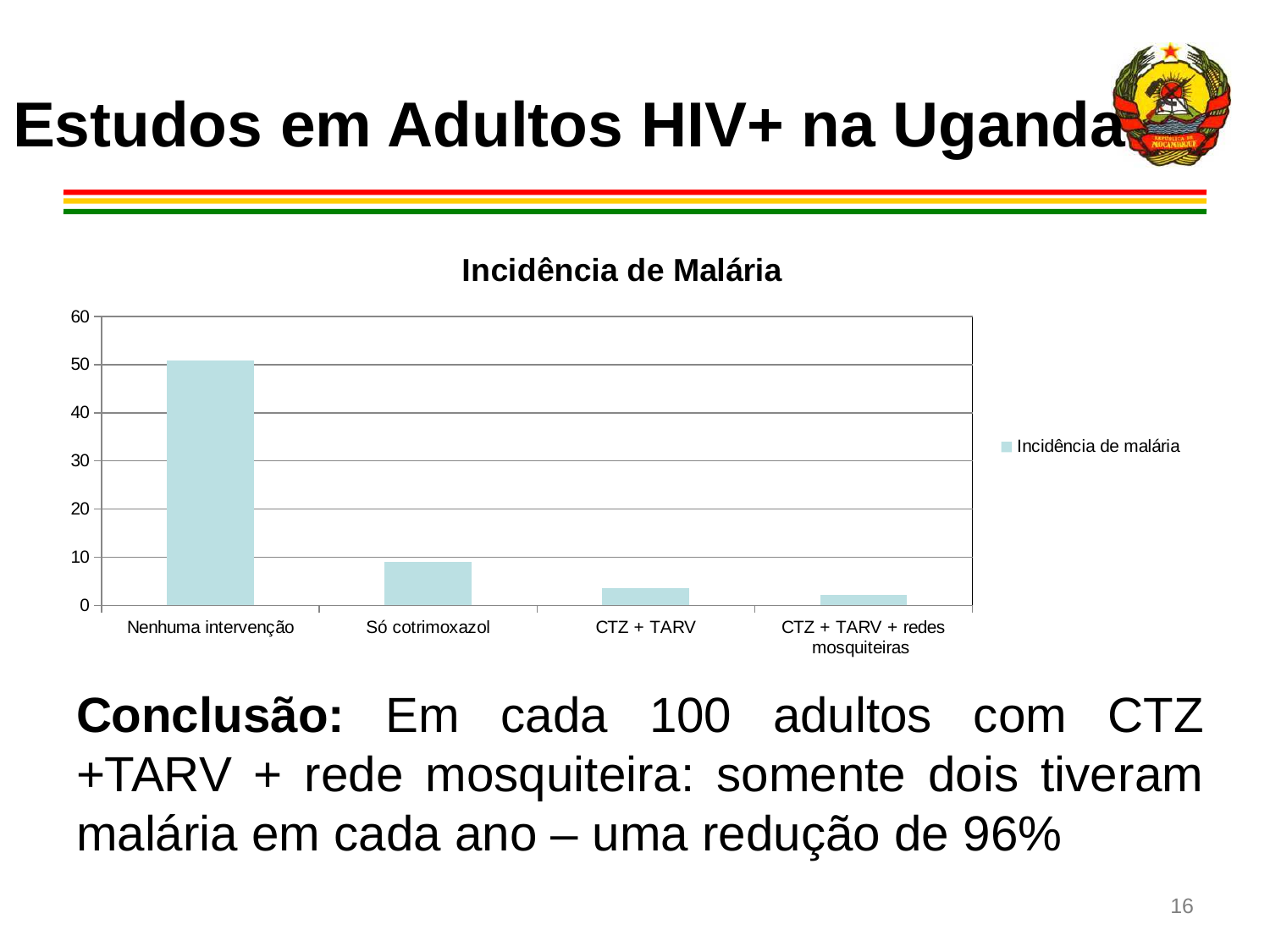
What kind of chart is shown on the slide? bar chart What is the title of the chart? Incidência de Malária Which has a higher malaria incidence, Só cotrimoxazol or CTZ + TARV? Só cotrimoxazol Is the value for Nenhuma intervenção greater or less than 40? greater How many series does the chart legend list? 1 Which category has the lowest malaria incidence? CTZ + TARV + redes mosquiteiras Which category has the highest malaria incidence? Nenhuma intervenção Which has a higher malaria incidence, Nenhuma intervenção or Só cotrimoxazol? Nenhuma intervenção Is the value for CTZ + TARV greater or less than 10? less What is the series name shown in the chart legend? Incidência de malária How many categories are shown on the x axis of the chart? 4 Do the values rise or fall moving from left to right along the x axis? fall